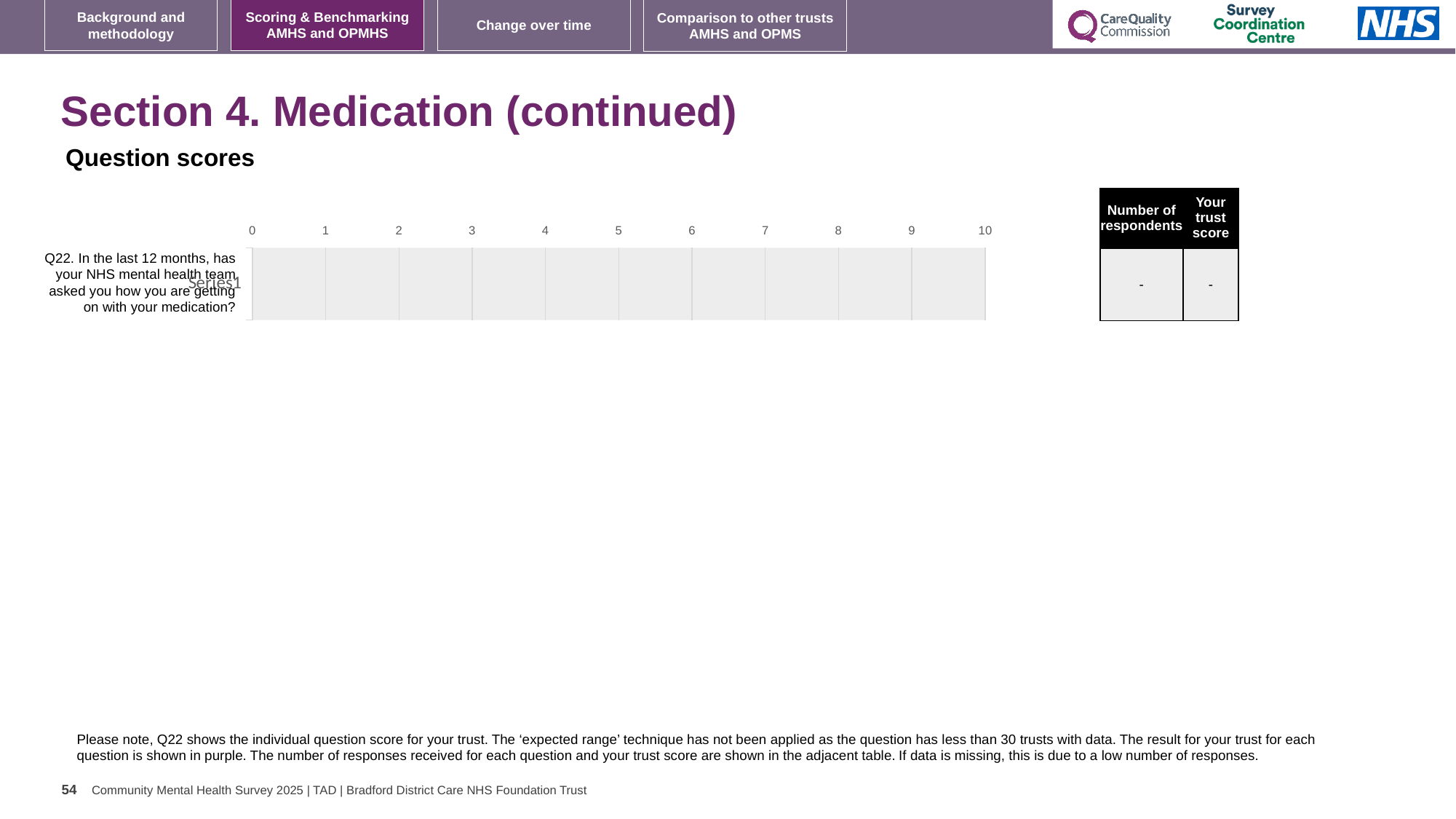
Is a plotted bar value visible for Q22 on the chart? No How many question categories are listed on the chart's vertical axis? 1 What is the highest value shown on the chart's horizontal axis? 10 What kind of chart is shown under 'Question scores'? bar chart Which question number is the category shown on the chart? Q22